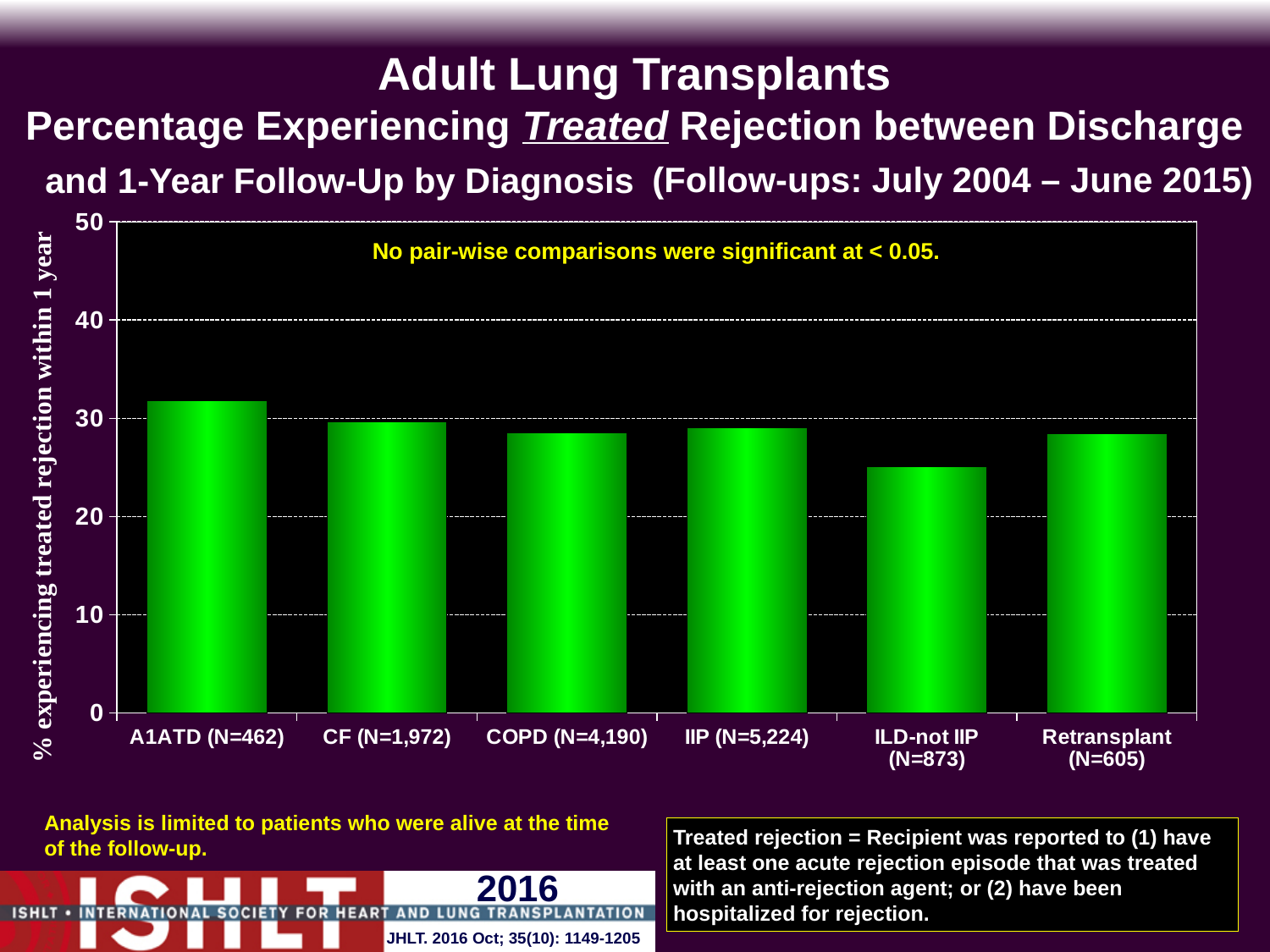
What is the label of the vertical axis? % experiencing treated rejection within 1 year Which diagnosis category has the highest percentage experiencing treated rejection within 1 year? A1ATD (N=462) How many diagnosis categories are plotted on the chart? 6 What kind of chart is shown on the slide? bar chart Is the value for COPD (N=4,190) greater or less than 30? less Is the value for A1ATD (N=462) greater or less than 30? greater Which diagnosis category has the lowest percentage experiencing treated rejection within 1 year? ILD-not IIP (N=873) Is the value for ILD-not IIP (N=873) greater or less than 30? less What does the note inside the chart area say about pair-wise comparisons? No pair-wise comparisons were significant at < 0.05. Which is larger, the value for A1ATD (N=462) or the value for ILD-not IIP (N=873)? A1ATD (N=462) Which is larger, the value for CF (N=1,972) or the value for ILD-not IIP (N=873)? CF (N=1,972)